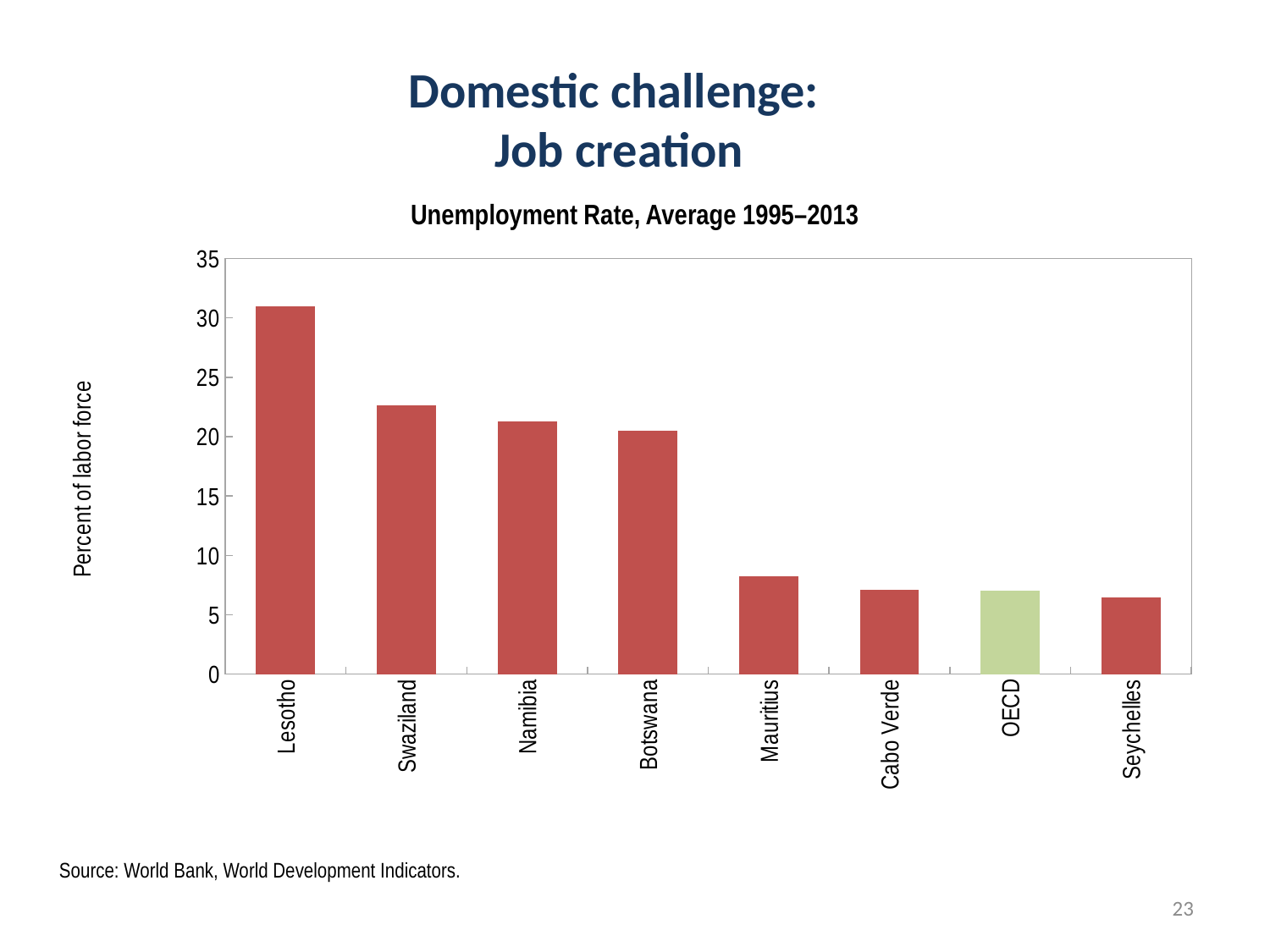
Is the value for Seychelles greater or less than 5? greater Do the values rise or fall moving from left to right along the x axis? fall Which is larger, the value for Lesotho or the value for Swaziland? Lesotho What kind of chart is shown on the slide? bar chart Is the value for Lesotho greater or less than 30? greater What is the title of the chart? Unemployment Rate, Average 1995–2013 Is the value for Mauritius greater or less than 10? less Which category has the lowest unemployment rate? Seychelles How many categories are plotted on the chart? 8 Which category has the highest unemployment rate? Lesotho Which is larger, the value for Botswana or the value for Mauritius? Botswana